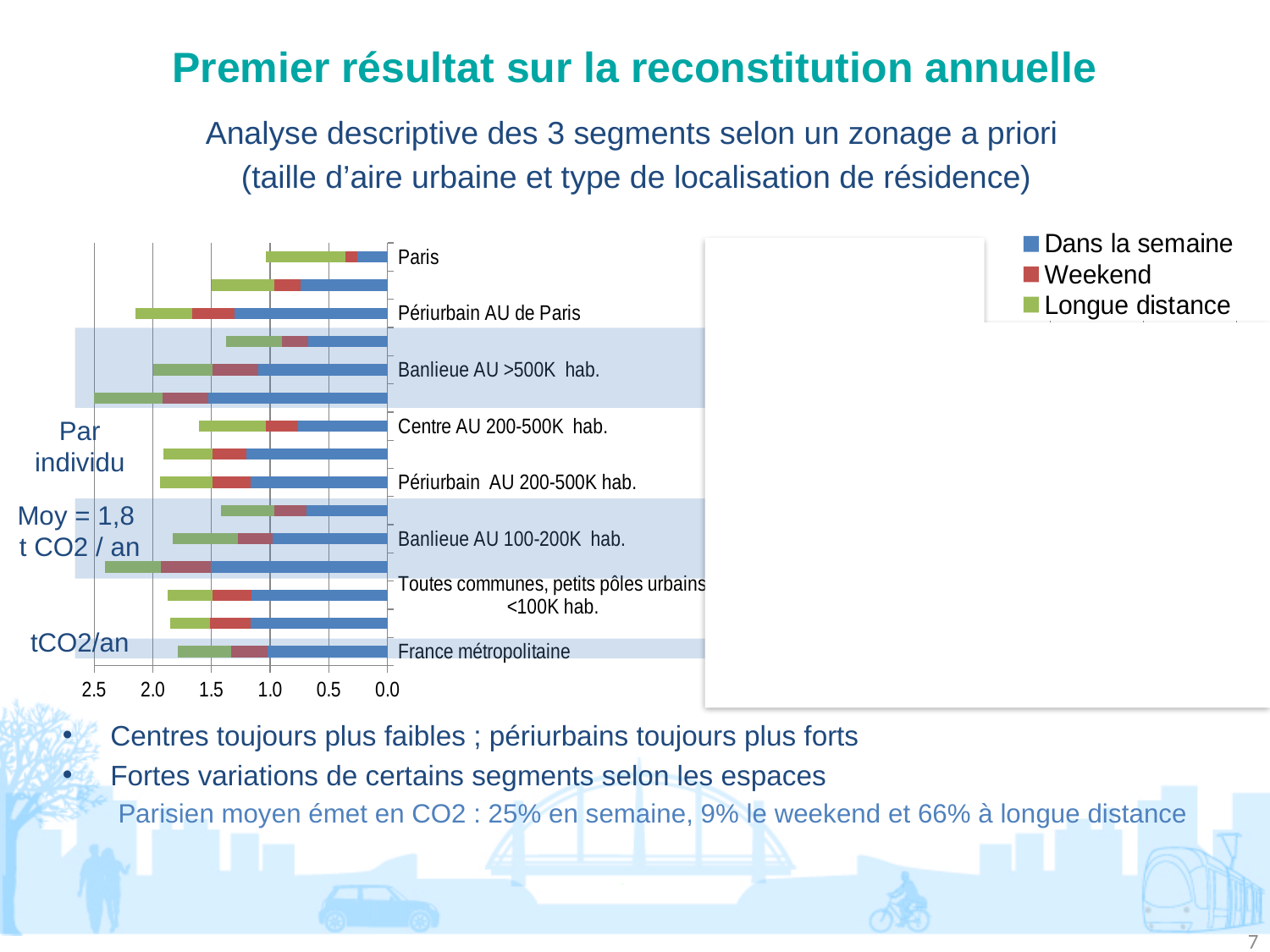
Which has the longer total bar, Paris or France métropolitaine? France métropolitaine What kind of chart is shown on the slide? stacked bar chart Is the total bar length for Paris greater or less than 1.5? less Is the total bar length for France métropolitaine greater or less than 1.5? greater Is the total bar length for France métropolitaine greater or less than 2.0? less How many series does the chart's legend list? 3 What is the largest value shown on the chart's axis? 2.5 What are the three series named in the chart's legend? Dans la semaine, Weekend, Longue distance